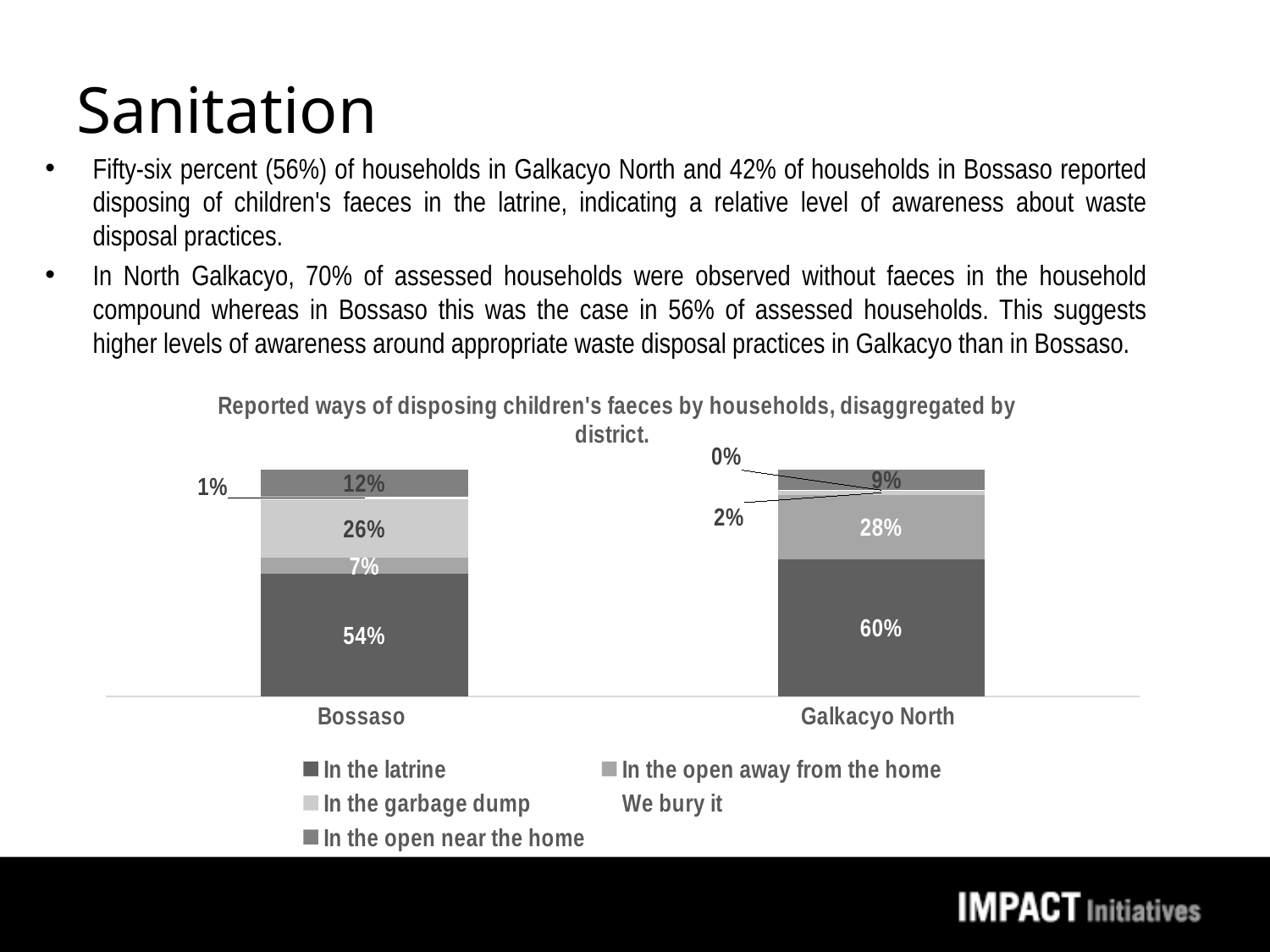
How many series does the chart legend list? 5 How many districts are shown on the x axis of the chart? 2 What is the title of the chart? Reported ways of disposing children's faeces by households, disaggregated by district. What percentage of households in Bossaso reported disposing of children's faeces in the latrine? 54% What percentage of households in Galkacyo North reported disposing of children's faeces in the latrine? 60% Which disposal method is the largest segment in the Bossaso bar? In the latrine What percentage of households in Bossaso reported disposing of children's faeces in the open near the home? 12% What is the difference between the 'In the latrine' values for Galkacyo North and Bossaso? 6% Which district has the higher share of households disposing of children's faeces in the latrine? Galkacyo North What type of chart is shown on the slide? Stacked bar chart What percentage of households in Bossaso reported disposing of children's faeces in the garbage dump? 26% What percentage of households in Galkacyo North reported disposing of children's faeces in the open near the home? 9%